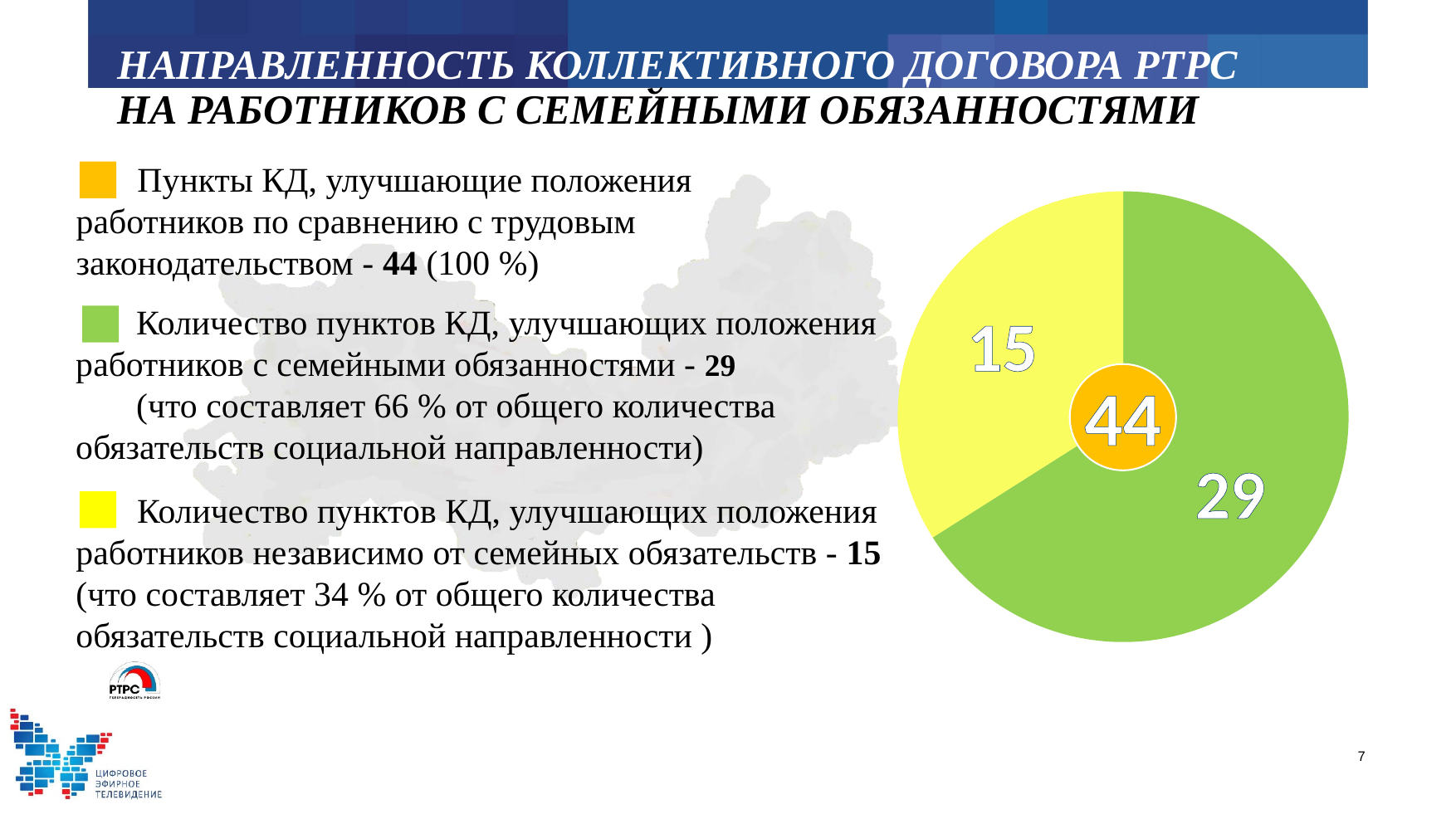
Which slice of the pie chart is the smallest? yellow (15) How many slices does the pie chart have? 2 What is the difference between the green slice (29) and the yellow slice (15) in the pie chart? 14 Which is larger in the pie chart: the green slice or the yellow slice? the green slice What value is shown on the green slice of the pie chart? 29 According to the slide text, what share of the total do the 15 items independent of family obligations (yellow slice) represent? 34 % According to the slide text, what share of the total do the 29 items for workers with family obligations (green slice) represent? 66 % What number is shown in the orange circle at the centre of the pie chart? 44 What kind of chart is shown on the slide? pie chart What is the total of the two slices in the pie chart (29 + 15)? 44 Which slice of the pie chart is the largest? green (29) What value is shown on the yellow slice of the pie chart? 15